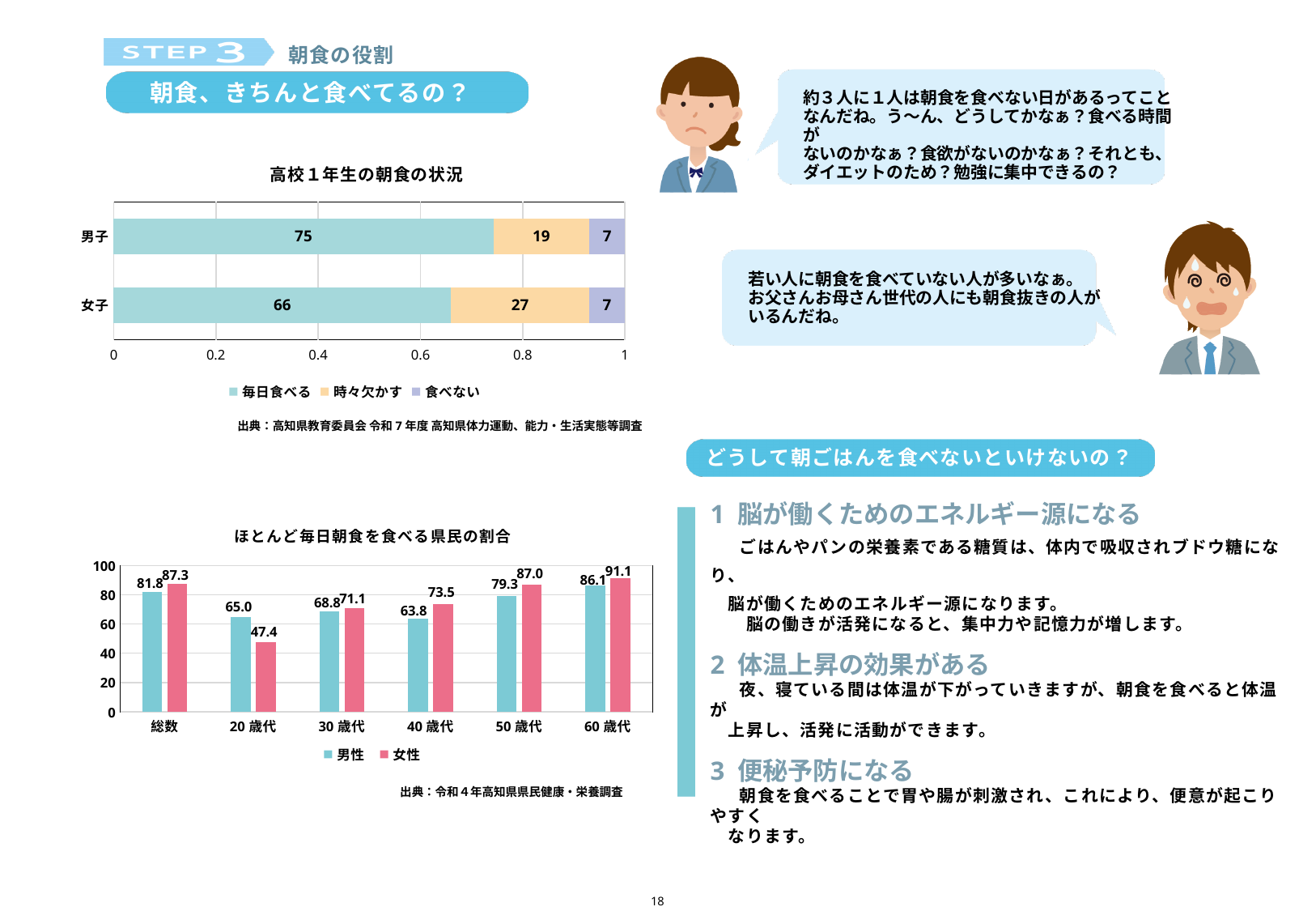
In the chart titled ほとんど毎日朝食を食べる県民の割合, what is the value of 男性 for 60歳代? 86.1 In the chart titled 高校１年生の朝食の状況, what is the difference between the 毎日食べる values for 男子 and 女子? 9 In the chart titled 高校１年生の朝食の状況, how many series does the legend list? 3 In the chart titled 高校１年生の朝食の状況, what is the total of the stacked bar for 女子? 100 In the chart titled 高校１年生の朝食の状況, what is the value of 時々欠かす for 女子? 27 In the chart titled 高校１年生の朝食の状況, what is the value of 毎日食べる for 男子? 75 In the chart titled ほとんど毎日朝食を食べる県民の割合, how many categories are shown on the x axis? 6 In the chart titled ほとんど毎日朝食を食べる県民の割合, what is the value of 女性 for 20歳代? 47.4 In the chart titled ほとんど毎日朝食を食べる県民の割合, which category has the lowest 男性 value? 40歳代 In the chart titled ほとんど毎日朝食を食べる県民の割合, which age category has the highest 女性 value? 60歳代 In the chart titled ほとんど毎日朝食を食べる県民の割合, which is larger for 20歳代, 男性 or 女性? 男性 In the chart titled ほとんど毎日朝食を食べる県民の割合, what is the difference between the 女性 and 男性 values for 40歳代? 9.7